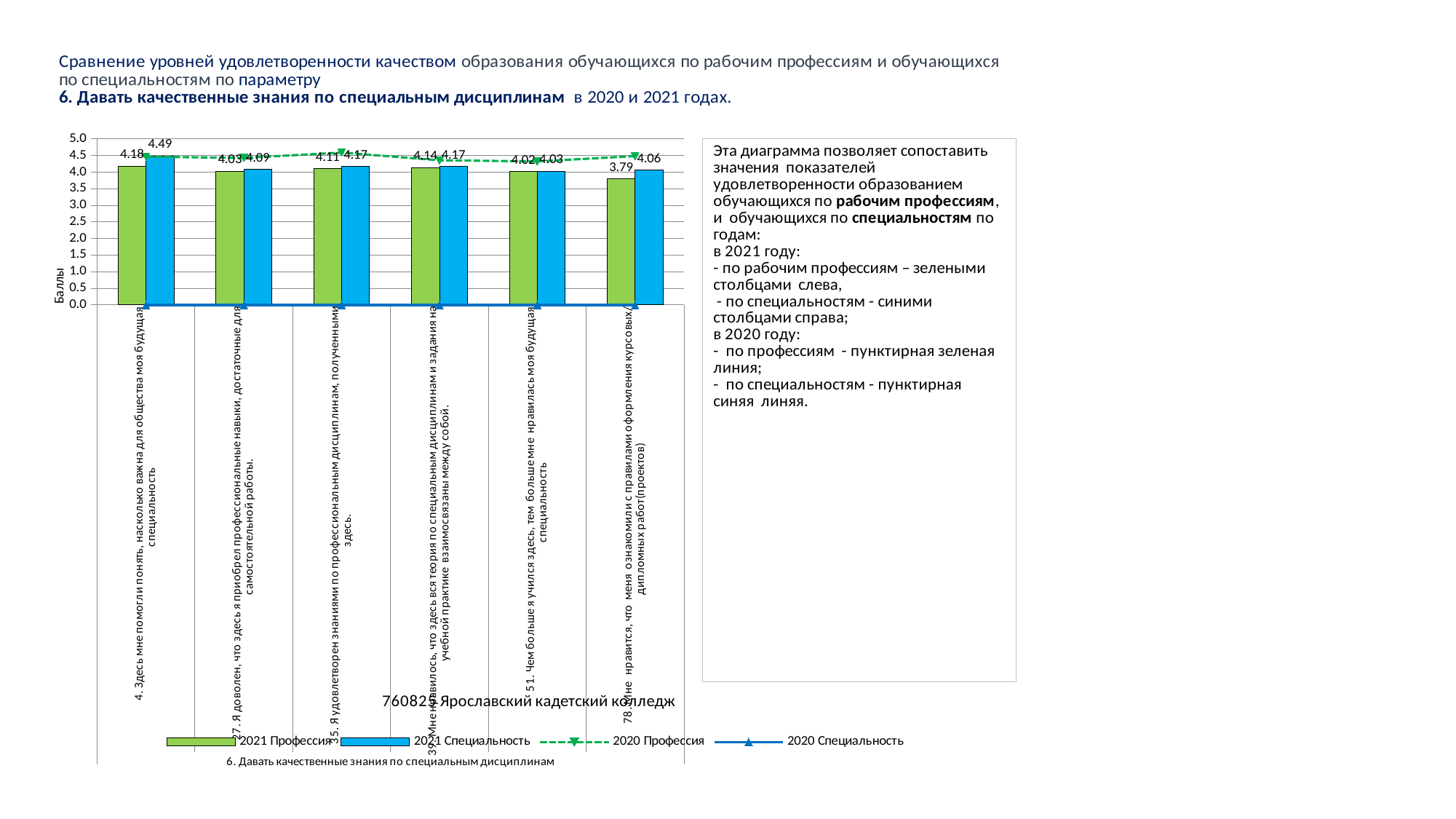
How many categories are shown on the x axis of the chart? 6 What is the value of the 2021 Профессия bar for category 4 ("Здесь мне помогли понять, насколько важна для общества моя будущая специальность")? 4.18 How many series does the chart legend list? 4 Which category has the lowest 2021 Профессия bar? 78. Мне нравится, что меня ознакомили с правилами оформления курсовых, дипломных работ(проектов) For category 78 ("Мне нравится, что меня ознакомили..."), which is larger: the 2021 Профессия bar or the 2021 Специальность bar? 2021 Специальность What is the title of the vertical axis of the chart? Баллы What is the value of the 2021 Специальность bar for category 51 ("Чем больше я учился здесь, тем больше мне нравилась моя будущая специальность")? 4.03 Which category has the highest 2021 Специальность bar? 4. Здесь мне помогли понять, насколько важна для общества моя будущая специальность What is the difference between the 2021 Специальность and 2021 Профессия values for category 4 ("Здесь мне помогли понять...")? 0.31 Is the 2021 Профессия value for category 78 greater or less than 4.0? less What is the value of the 2021 Профессия bar for category 78 ("Мне нравится, что меня ознакомили с правилами оформления курсовых, дипломных работ")? 3.79 What is the value of the 2021 Специальность bar for category 4 ("Здесь мне помогли понять...")? 4.49